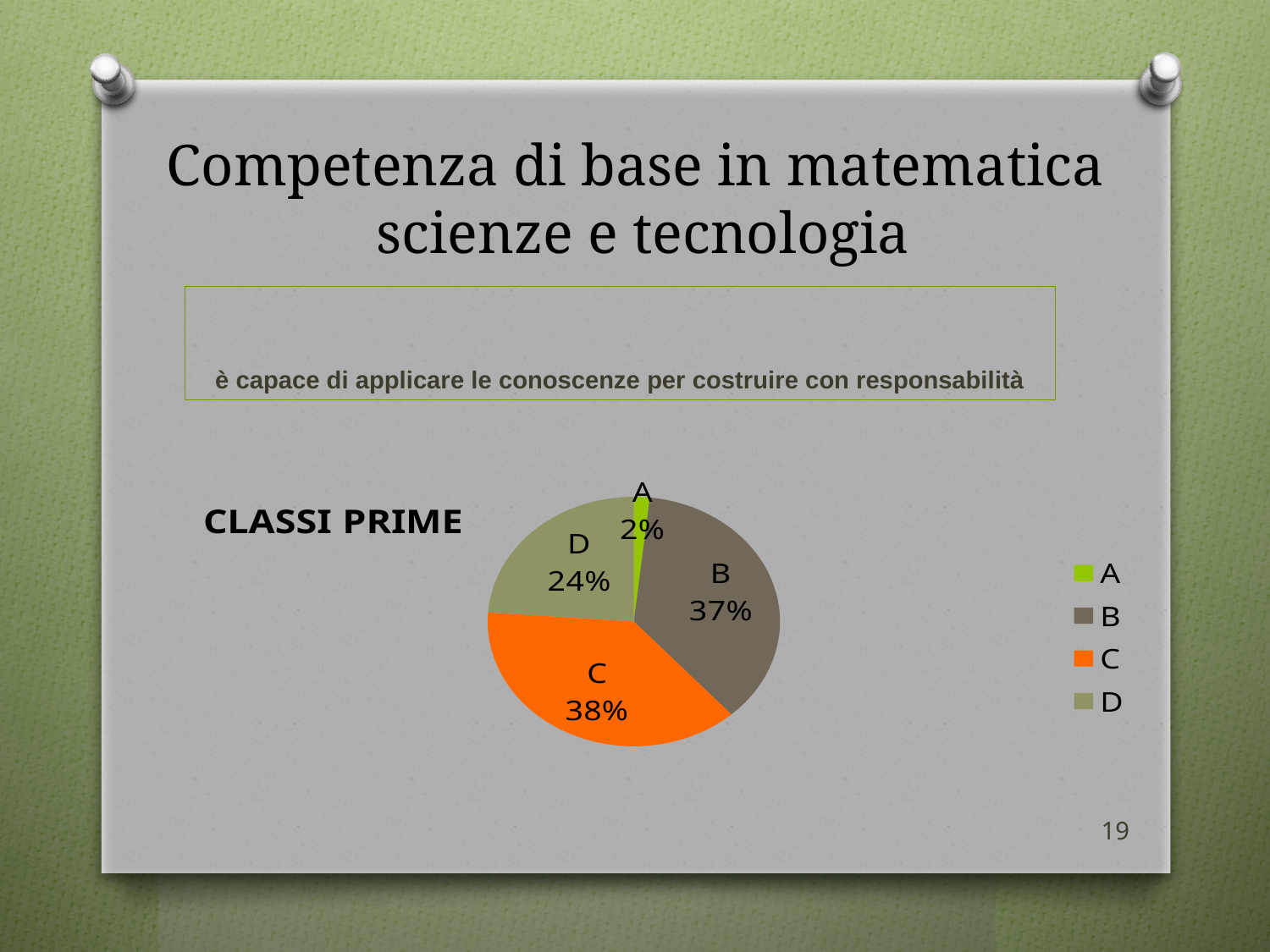
Which is larger, slice B or slice D? B What colour is slice C in the pie chart? orange Which slice of the pie is the smallest? A How many slices does the pie chart have? 4 What share of the pie does slice D represent? 24% What share of the pie does slice B represent? 37% What is the combined share of slices B and C? 75% What share of the pie does slice C represent? 38% What is the difference in percentage points between slice D and slice A? 22 What kind of chart is shown on the slide? pie chart How many entries does the legend list? 4